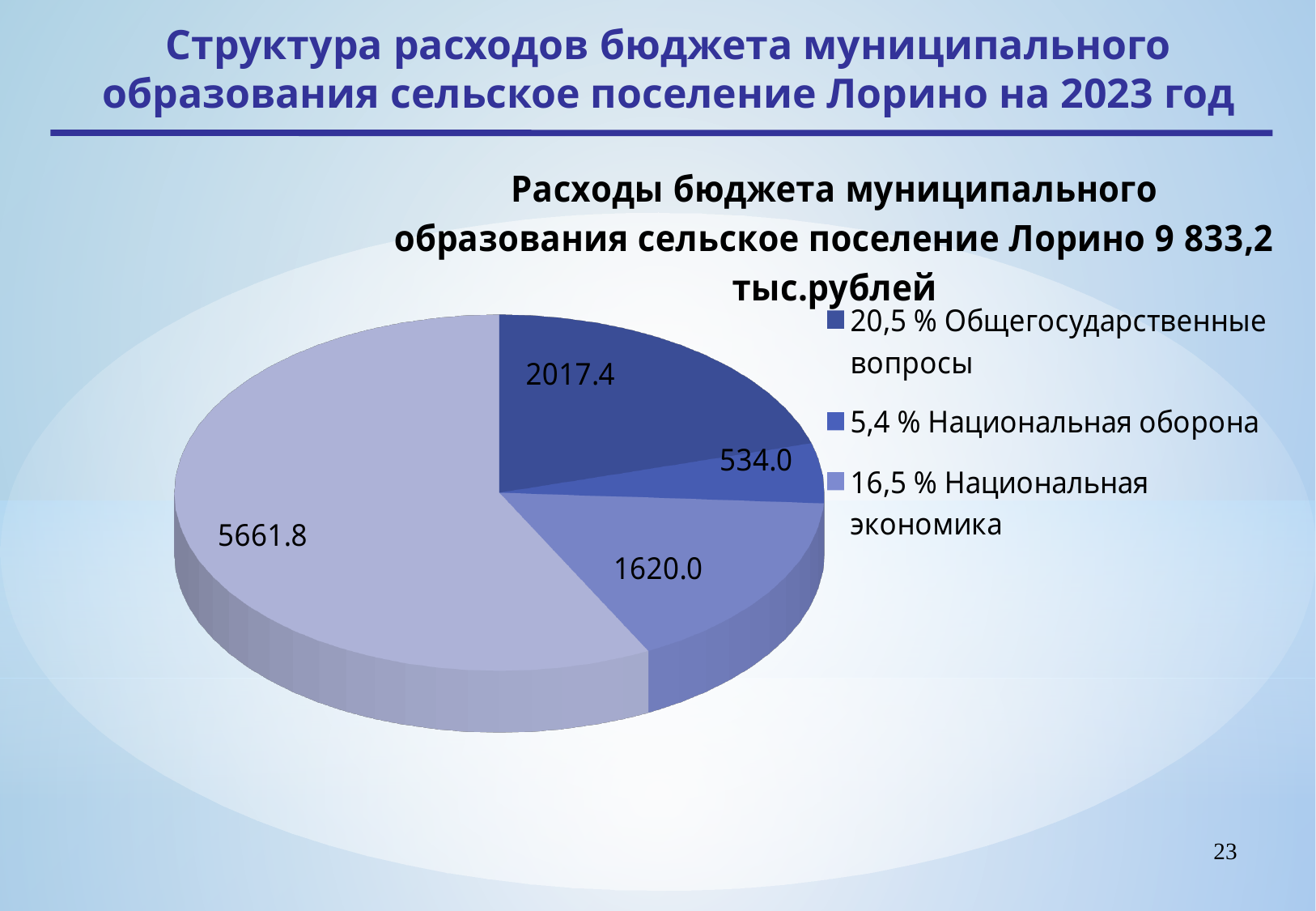
Which is larger, the slice for Общегосударственные вопросы or the slice for Национальная экономика? Общегосударственные вопросы Which legend category has the smallest slice? Национальная оборона What is the value of the slice for Национальная оборона? 534.0 How many entries does the legend list? 3 What is the largest value labelled on the pie chart? 5661.8 What total amount in тыс.рублей is stated in the chart title? 9 833,2 What is the difference between the values for Общегосударственные вопросы and Национальная оборона? 1483.4 How many slices does the pie chart have? 4 What is the value of the slice for Национальная экономика? 1620.0 What is the value of the slice for Общегосударственные вопросы? 2017.4 What kind of chart is shown on the slide? pie chart What share of the pie does Национальная оборона represent according to the legend? 5,4 %